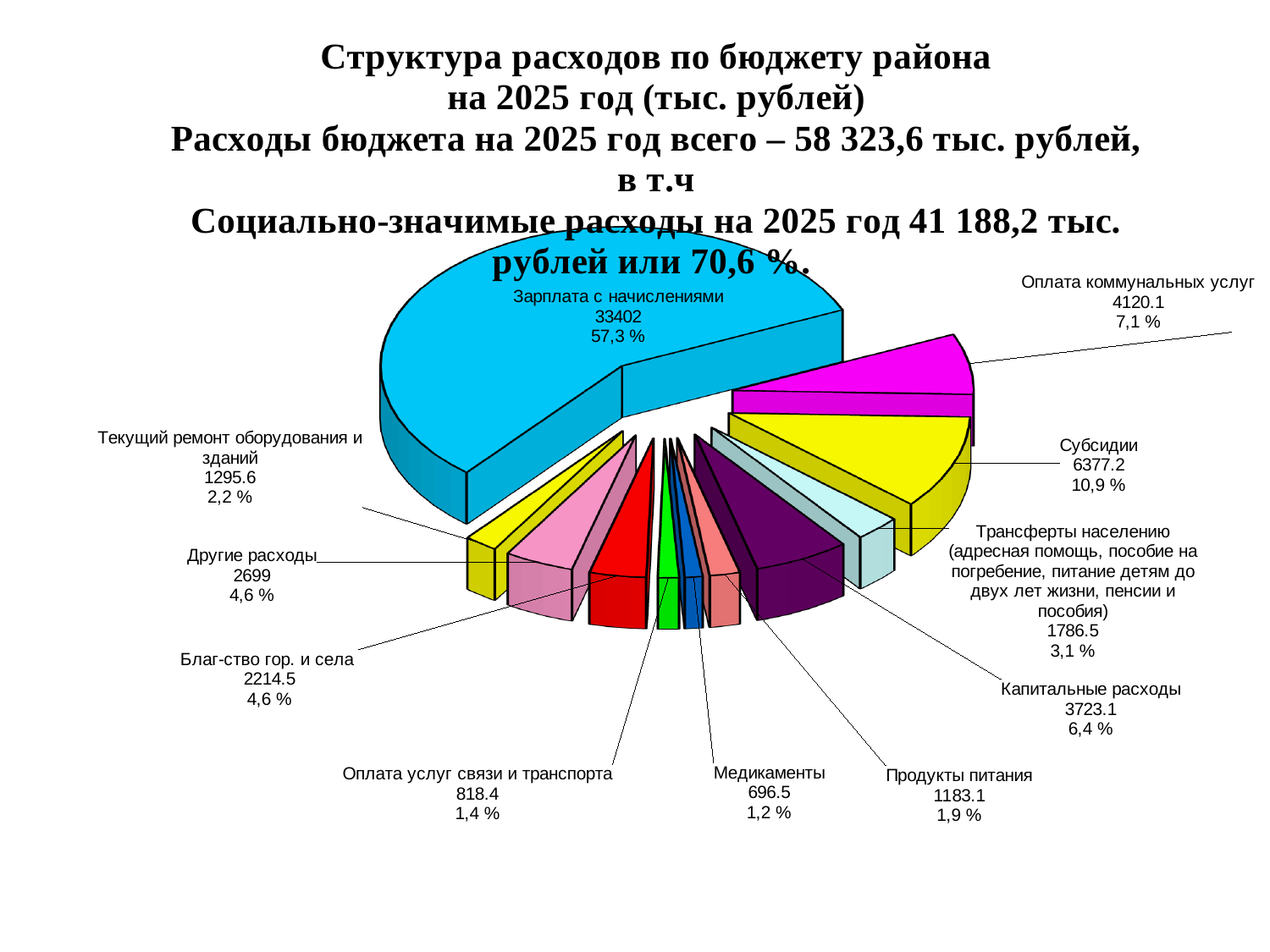
Which category has the largest slice of the pie? Зарплата с начислениями What share of the pie does Зарплата с начислениями represent? 57,3 % How many categories (slices) does the pie chart show? 11 What is the difference between the values for Субсидии and Оплата коммунальных услуг? 2257.1 What is the value for Зарплата с начислениями? 33402 What share of the pie does Текущий ремонт оборудования и зданий represent? 2,2 % What share of the pie does Оплата коммунальных услуг represent? 7,1 % What type of chart is shown on the slide? Pie chart What is the value for Продукты питания? 1183.1 Which is larger: Капитальные расходы or Оплата коммунальных услуг? Оплата коммунальных услуг What is the value for Субсидии? 6377.2 Which category has the smallest slice of the pie? Медикаменты